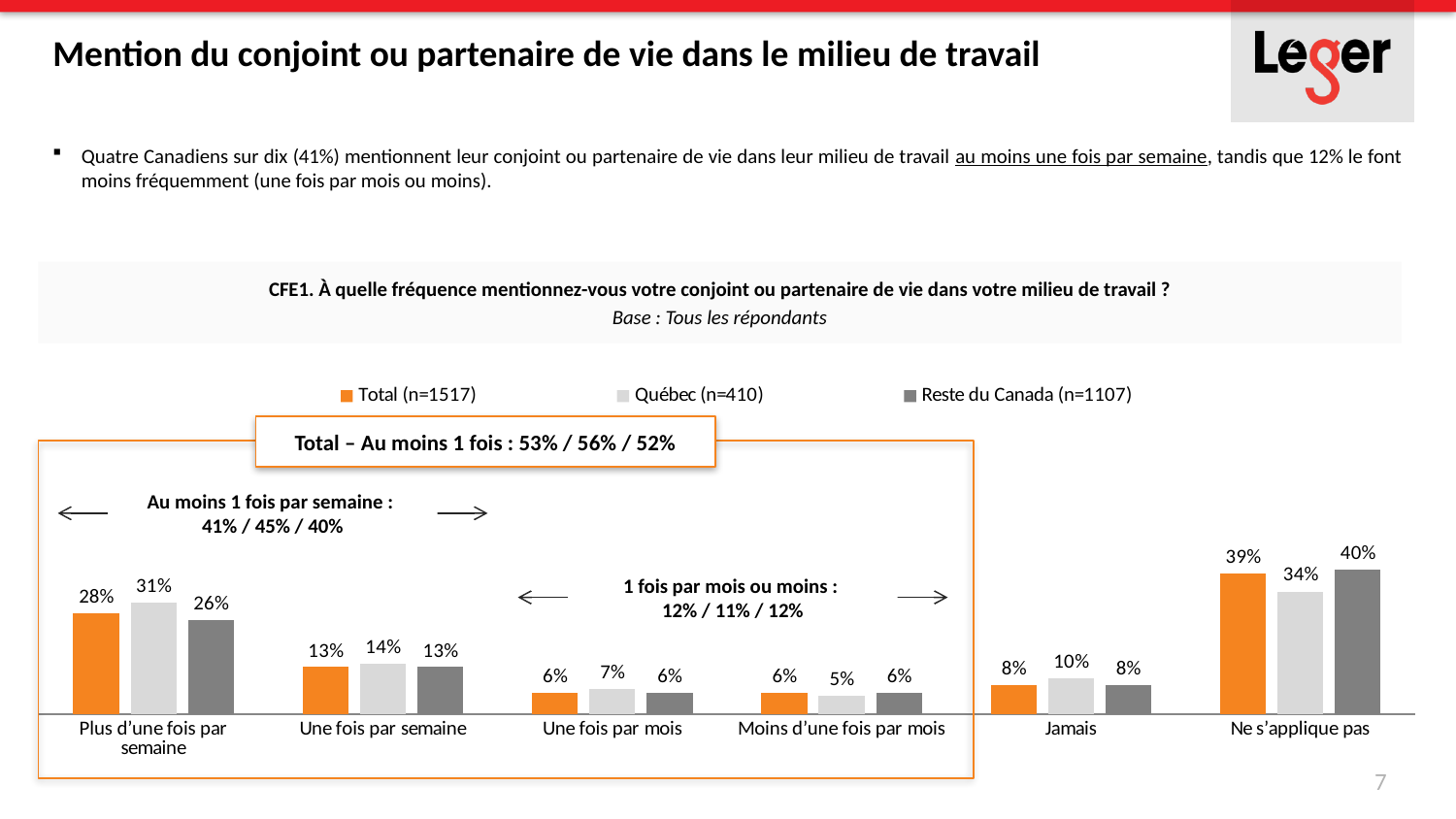
How many categories are shown on the x axis? 6 What is the difference between the Total (n=1517) values for "Plus d'une fois par semaine" and "Une fois par semaine"? 15% What is the Total (n=1517) value for "Plus d'une fois par semaine"? 28% For "Ne s'applique pas", which is larger: the Total (n=1517) value or the Québec (n=410) value? Total (n=1517) Which category has the highest Total (n=1517) value? Ne s'applique pas What kind of chart is shown on the slide? bar chart What is the Reste du Canada (n=1107) value for "Ne s'applique pas"? 40% How many series does the legend list? 3 Which category has the lowest Québec (n=410) value? Moins d'une fois par mois What is the difference between the Québec (n=410) and Reste du Canada (n=1107) values for "Plus d'une fois par semaine"? 5% Which series is shown in orange in the legend? Total (n=1517) What is the Québec (n=410) value for "Jamais"? 10%